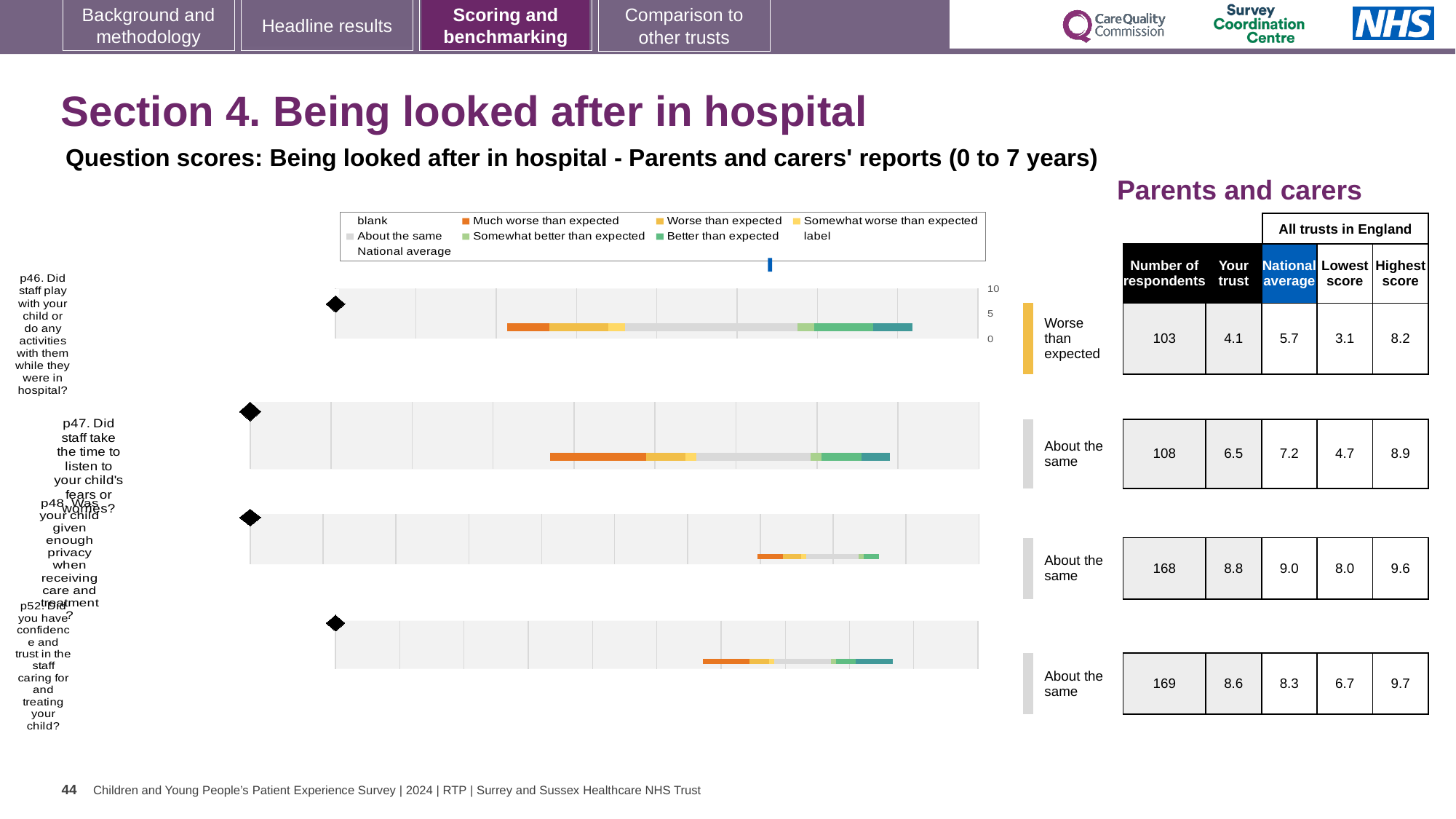
What benchmark category is shown next to the chart for p46 (Did staff play with your child or do any activities with them while they were in hospital?)? Worse than expected What benchmark category is shown next to the chart for p47 (Did staff take the time to listen to your child's fears or worries?)? About the same Which question has the highest 'Your trust' score? p48. Was your child given enough privacy when receiving care and treatment? What is the national average score for p47 (Did staff take the time to listen to your child's fears or worries?)? 7.2 What is the 'Your trust' score for p46 (Did staff play with your child or do any activities with them while they were in hospital?)? 4.1 For p46, what is the difference between the national average score and the 'Your trust' score? 1.6 What kind of chart is used to show the question scores on this slide? bar chart For p52, which is larger: the 'Your trust' score or the national average score? Your trust Which question has the lowest 'Your trust' score? p46. Did staff play with your child or do any activities with them while they were in hospital? What is the highest score across all trusts in England for p52 (Did you have confidence and trust in the staff caring for and treating your child?)? 9.7 How many survey questions (charts) are shown on the slide? 4 How many respondents are shown for p48 (Was your child given enough privacy when receiving care and treatment?)? 168